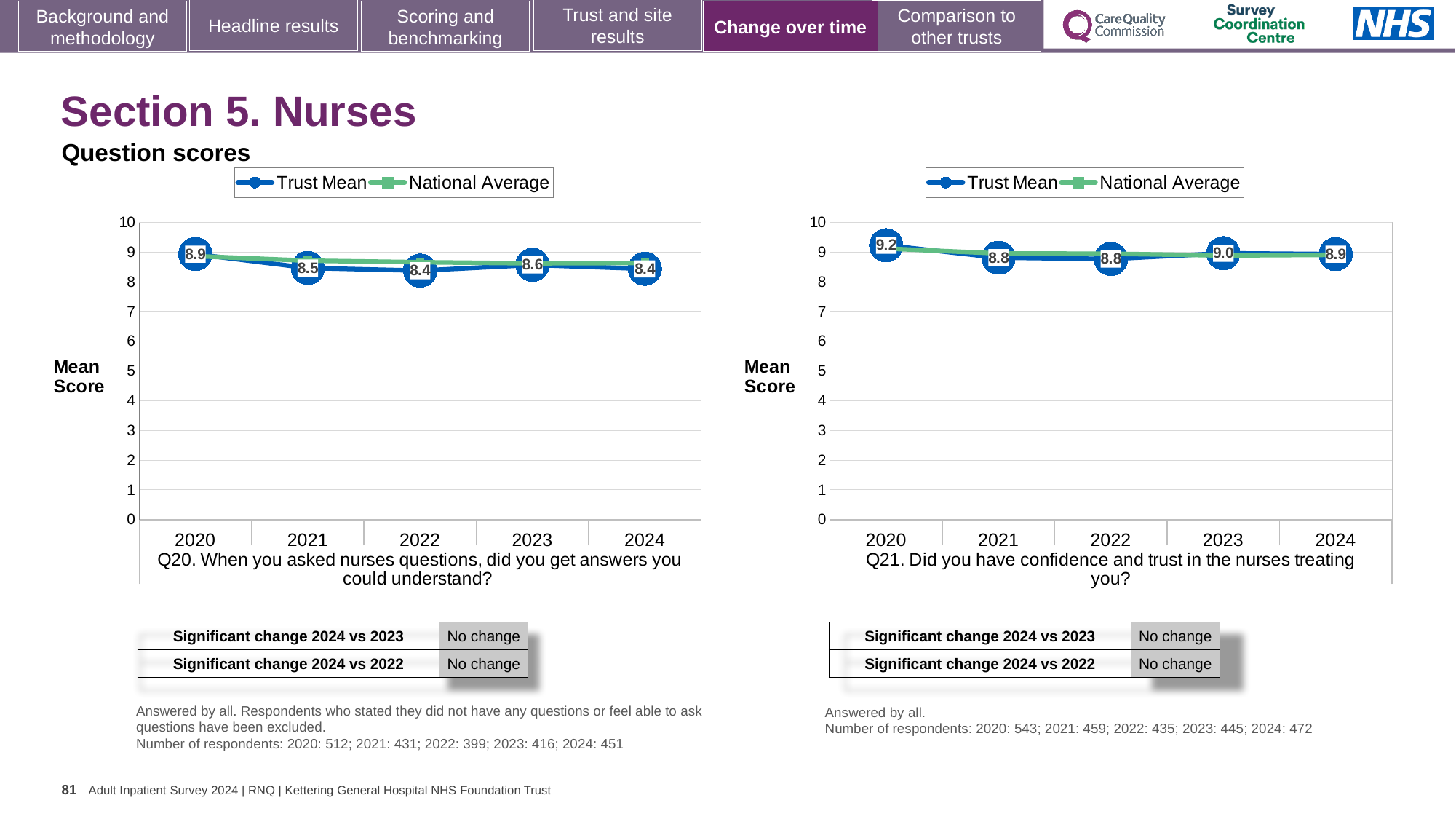
In the Q21 chart, which year has the highest Trust Mean score? 2020 What type of chart is used for Q21? Line chart In the Q21 chart, is the Trust Mean score higher in 2023 or in 2024? 2023 In the Q21 chart, what is the Trust Mean score for 2023? 9.0 In the Q21 chart, what is the difference between the Trust Mean scores for 2020 and 2024? 0.3 In the Q20 chart, which year has the highest Trust Mean score? 2020 In the Q20 chart, what is the Trust Mean score for 2020? 8.9 In the Q20 chart, what is the difference between the Trust Mean scores for 2020 and 2022? 0.5 How many years are shown on the x axis of the Q21 chart? 5 How many series does the legend of the Q20 chart list? 2 In the Q20 chart, what is the Trust Mean score for 2024? 8.4 In the Q20 chart, is the National Average value for 2022 greater or less than 8? greater